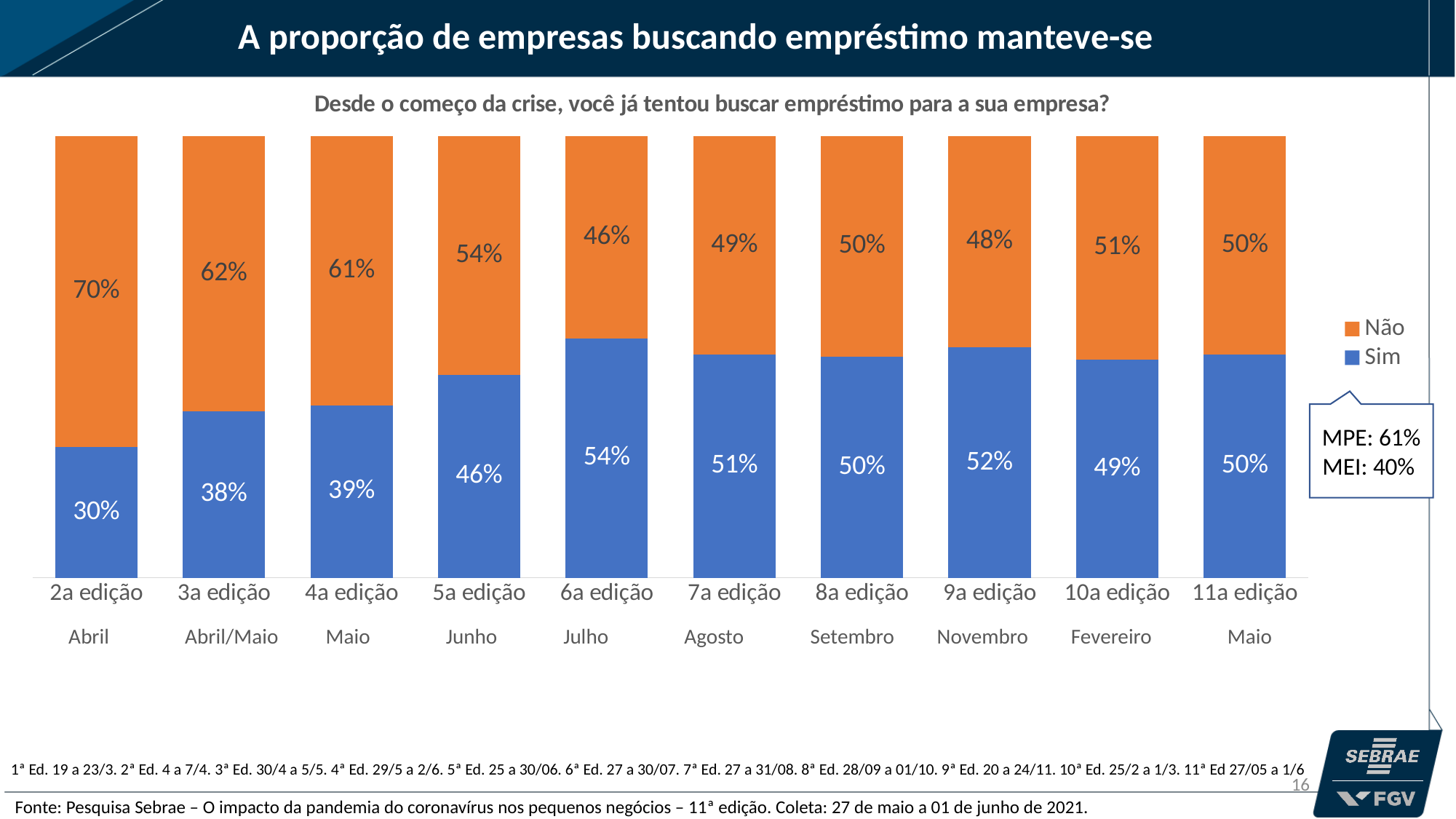
What is the value of "Não" for 5a edição? 54% How many editions are shown on the x axis? 10 Which edition has the highest "Sim" value? 6a edição Does the "Sim" value rise or fall from 2a edição to 6a edição? Rise What is the difference between the "Não" value for 2a edição and the "Não" value for 11a edição? 20 percentage points Which is larger: the "Sim" value for 9a edição or the "Sim" value for 10a edição? 9a edição What kind of chart is shown on the slide? Stacked bar chart Which edition has the lowest "Sim" value? 2a edição What is the total of the stacked bar for 7a edição? 100% What is the value of "Sim" for 11a edição? 50% What is the value of "Sim" for 2a edição? 30% How many series does the legend list? 2